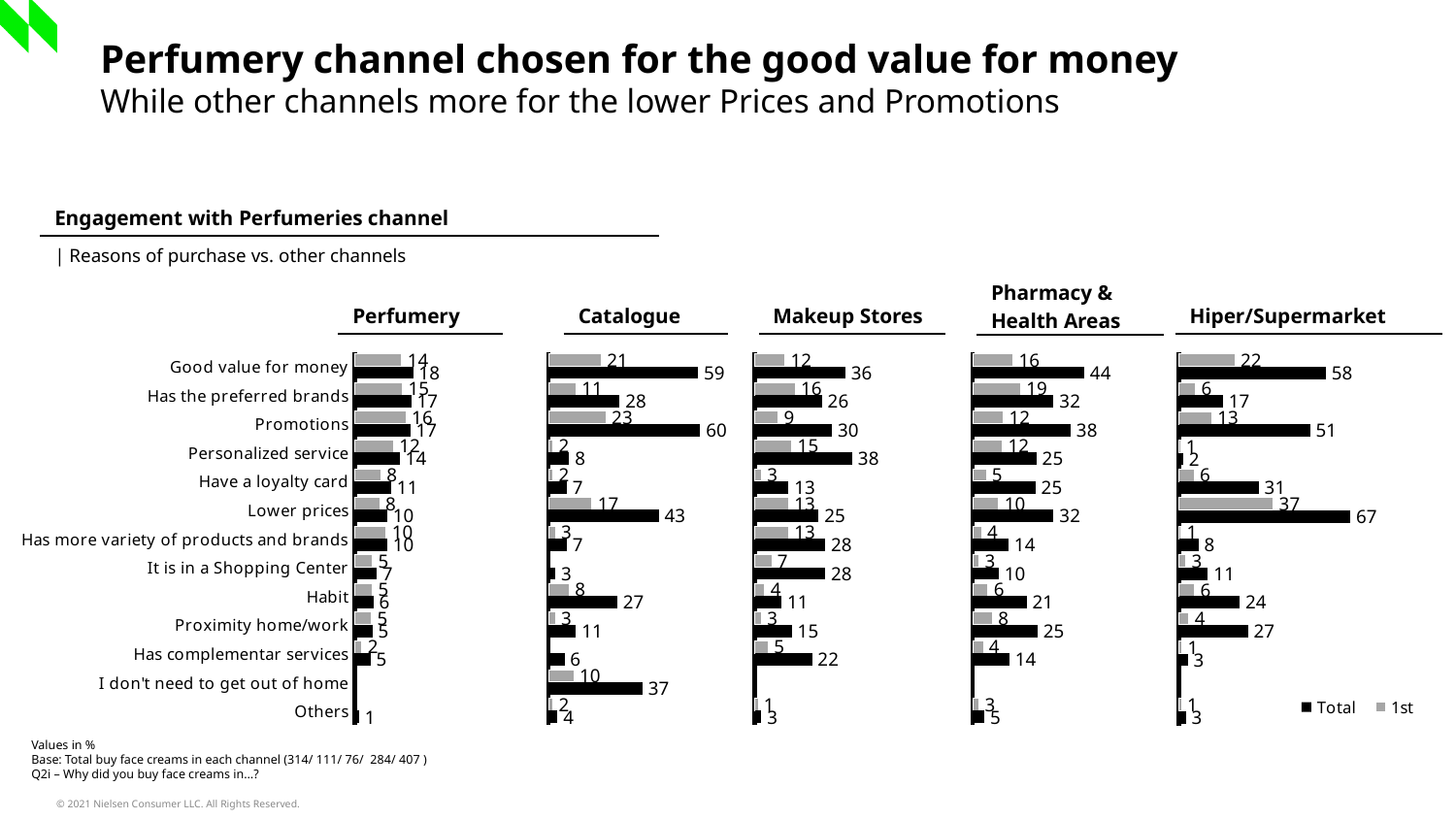
In the Pharmacy & Health Areas chart, what is the Total value for Good value for money? 44 What kind of chart is used for each channel on this slide? Bar chart In the Makeup Stores chart, what is the difference between the Total values for Personalized service and Good value for money? 2 In the Pharmacy & Health Areas chart, what is the 1st value for Has the preferred brands? 19 Which colour represents the Total series in the legend? Black In the Hiper/Supermarket chart, which reason has the highest Total value? Lower prices How many series does the legend list? 2 In the Hiper/Supermarket chart, what is the 1st value for Lower prices? 37 In the Catalogue chart, what is the Total value for Promotions? 60 In the Makeup Stores chart, which reason has the highest Total value? Personalized service In the Perfumery chart, what is the difference between the Total and 1st values for Good value for money? 4 In the Catalogue chart, which is larger: the Total value for Good value for money or the Total value for Lower prices? Good value for money